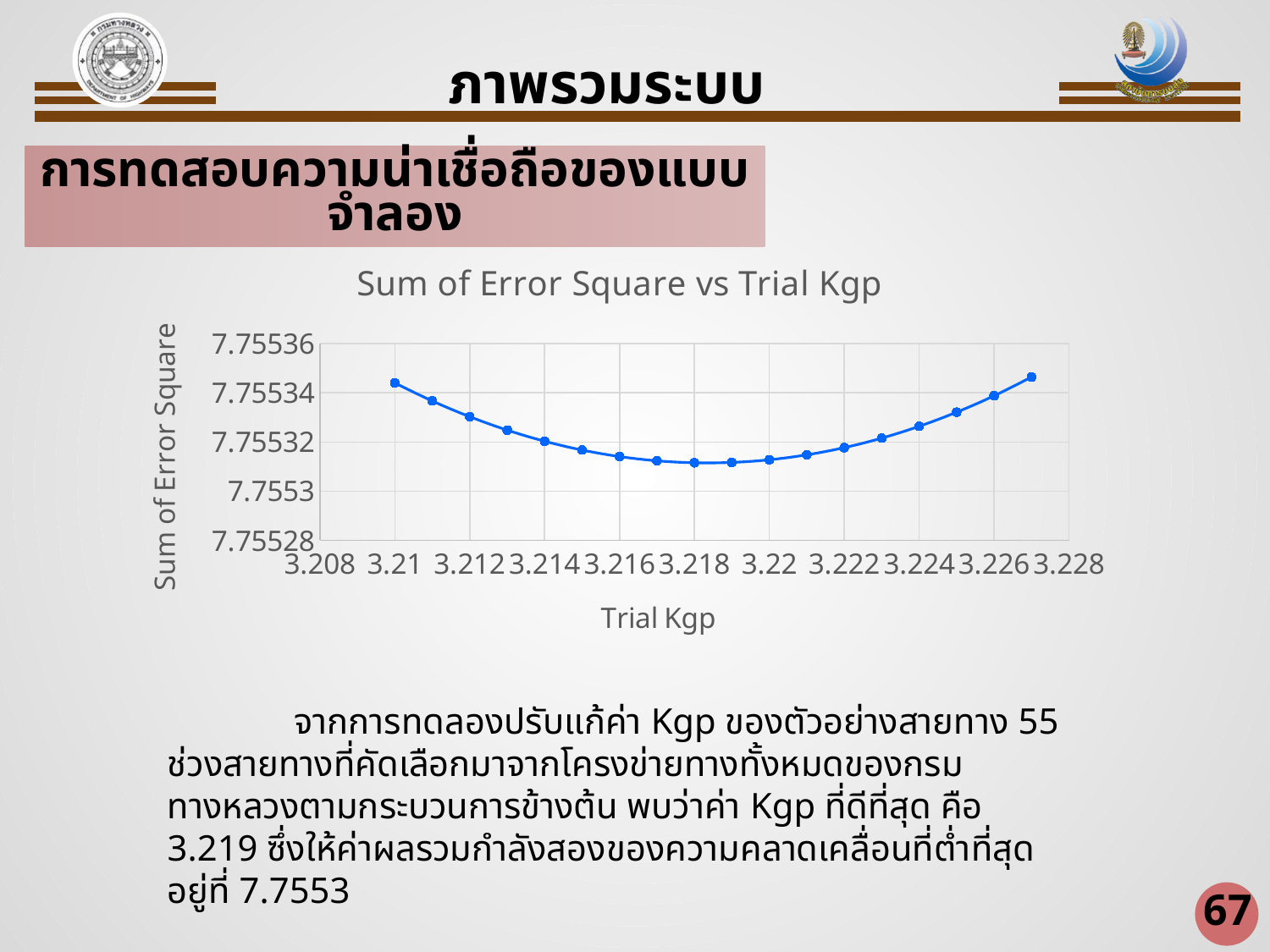
What is the title of the chart? Sum of Error Square vs Trial Kgp What is the label of the vertical axis of the chart? Sum of Error Square Which has the larger Sum of Error Square, Trial Kgp 3.21 or Trial Kgp 3.218? 3.21 What is the lowest value shown on the vertical axis of the chart? 7.75528 Do the values fall or rise as Trial Kgp increases from 3.21 to 3.218? fall Which has the larger Sum of Error Square, Trial Kgp 3.22 or Trial Kgp 3.227? 3.227 Is the Sum of Error Square at Trial Kgp 3.21 greater or less than 7.75532? greater Is the Sum of Error Square at Trial Kgp 3.218 greater or less than 7.75532? less What kind of chart is shown on the slide? line chart How many data points are plotted on the chart? 18 Do the values fall or rise as Trial Kgp increases from 3.22 to 3.227? rise Is the Sum of Error Square at Trial Kgp 3.227 greater or less than 7.75532? greater